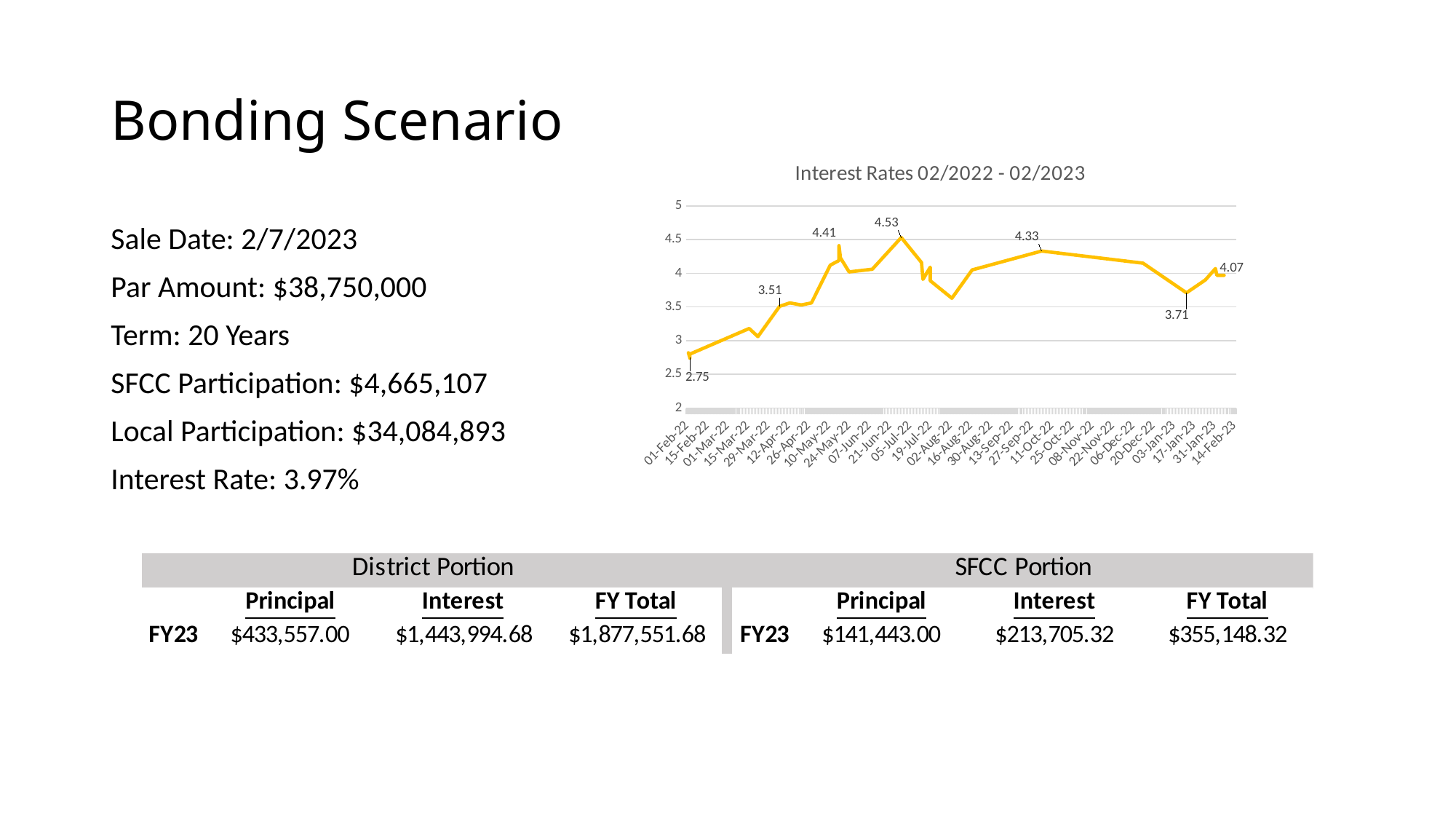
Is the interest rate at 01-Feb-22 greater or less than 3? less What is the lowest labeled interest rate on the chart? 2.75 Does the interest rate generally rise or fall from 01-Feb-22 to the peak in early July 2022? rise What is the title of the chart? Interest Rates 02/2022 - 02/2023 How many data labels are printed on the line? 7 What kind of chart is shown on the slide? line chart What is the difference between the labeled values 4.41 and 4.53? 0.12 Is the interest rate around 17-Jan-23 greater or less than 4? less What is the highest labeled interest rate on the chart? 4.53 What is the difference between the highest labeled value (4.53) and the lowest labeled value (2.75)? 1.78 Which labeled value is larger, 4.33 or 4.41? 4.41 What is the interest rate labeled at the first point of the line (01-Feb-22)? 2.75